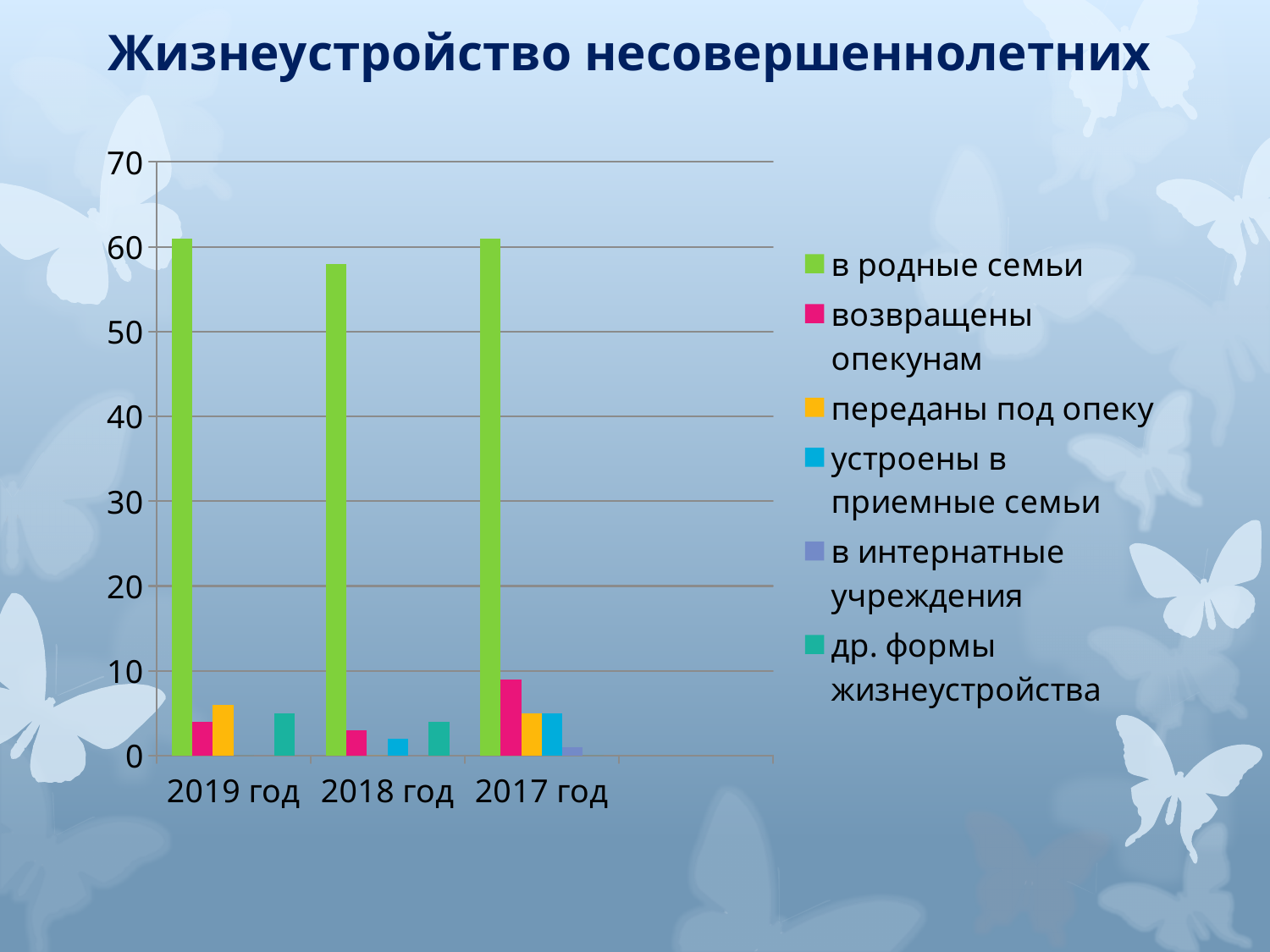
Which is larger, the value for "в родные семьи" in 2019 год or in 2018 год? 2019 год Is the value for "в родные семьи" in 2019 год greater or less than 50? greater Which series has the lowest value in 2017 год? др. формы жизнеустройства Which series is shown in green in the legend? в родные семьи Is the value for "в родные семьи" in 2018 год greater or less than 50? greater Is the value for "возвращены опекунам" in 2017 год greater or less than 20? less How many year categories are shown on the x axis? 3 What is the title of the chart? Жизнеустройство несовершеннолетних Which series has the highest value in 2019 год? в родные семьи How many series does the legend list? 6 What kind of chart is shown on the slide? Bar chart